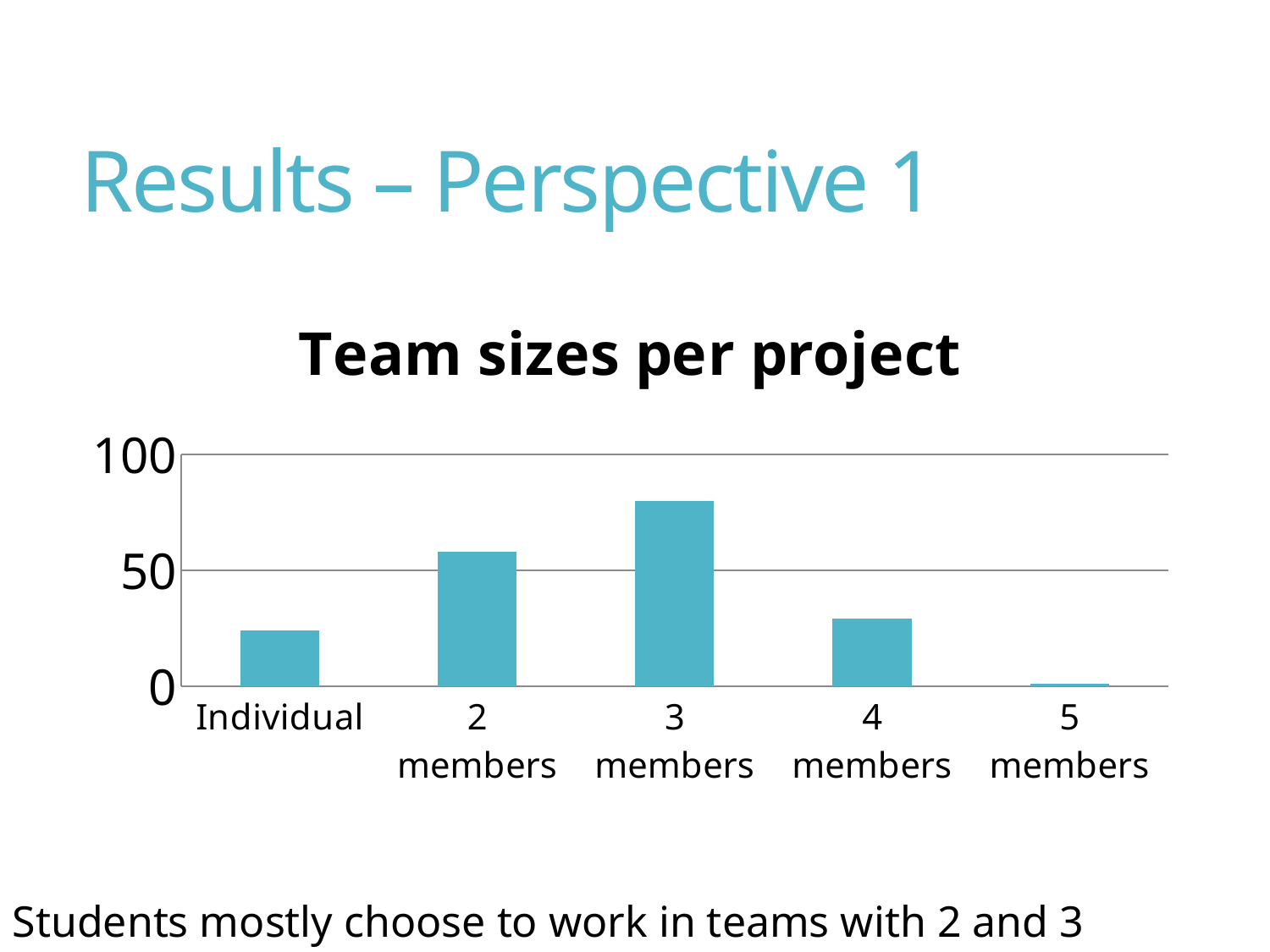
Which is larger, the value for 2 members or the value for 4 members? 2 members Which is larger, the value for 3 members or the value for Individual? 3 members Which category has the lowest value in the chart? 5 members Which category has the highest value in the chart? 3 members What type of chart is shown on the slide? bar chart How many categories are shown on the x axis of the chart? 5 Is the value for 5 members greater or less than 50? less Is the value for 2 members greater or less than 50? greater Is the value for 4 members greater or less than 50? less What is the title of the chart? Team sizes per project